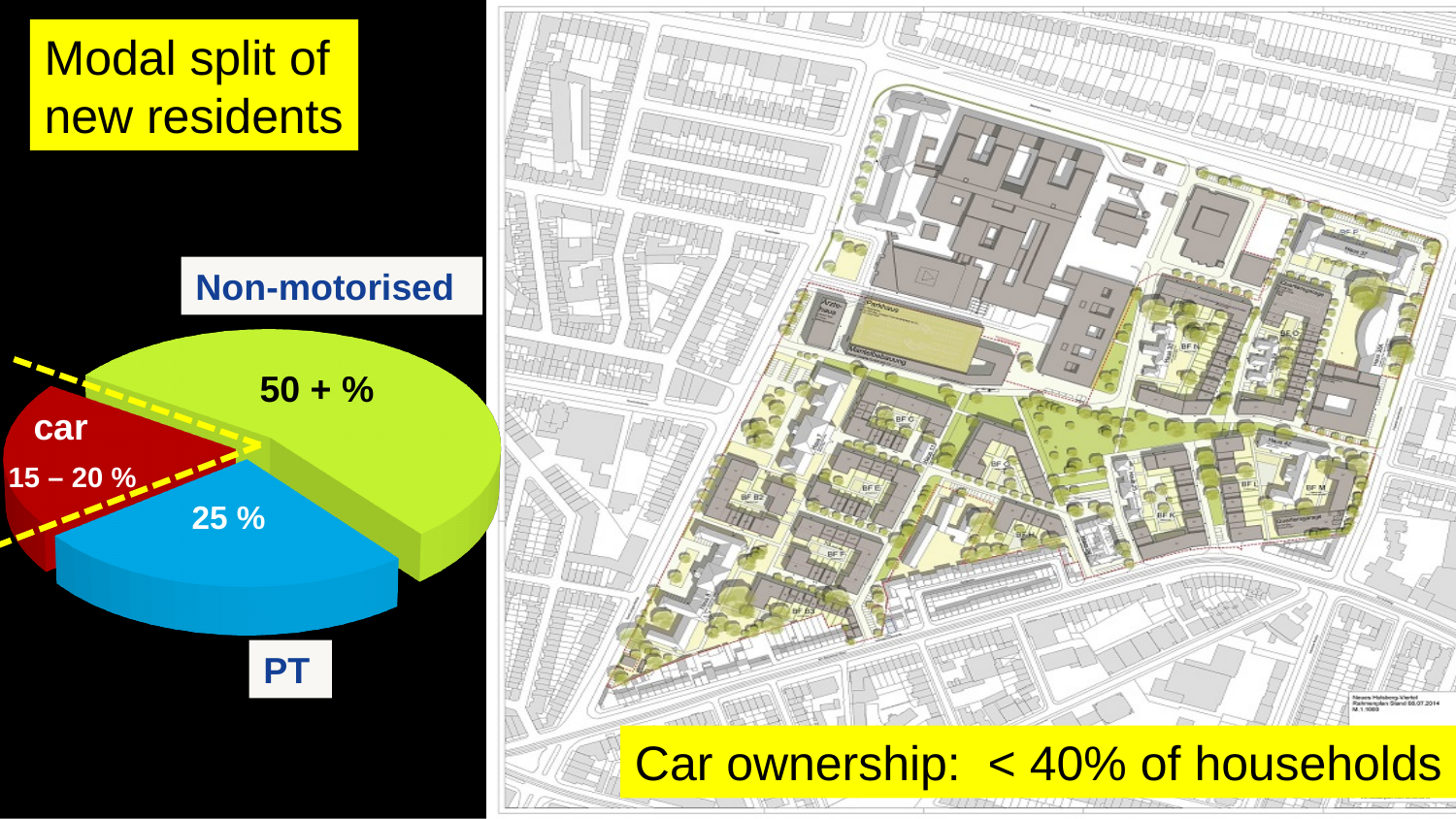
Which slice of the modal split pie chart is the largest? Non-motorised What share of the modal split pie chart is labelled for PT? 25 % How many slices does the modal split pie chart have? 3 Which slice of the modal split pie chart is the smallest? car In the modal split pie chart, which is larger, Non-motorised or PT? Non-motorised In the modal split pie chart, which is larger, PT or car? PT What colour is the PT slice in the modal split pie chart? blue What share of the modal split pie chart is labelled for car? 15 – 20 % What is the title of the chart on the left of the slide? Modal split of new residents What kind of chart is shown on the left of the slide? pie chart What share of the modal split pie chart is labelled for Non-motorised? 50 + %